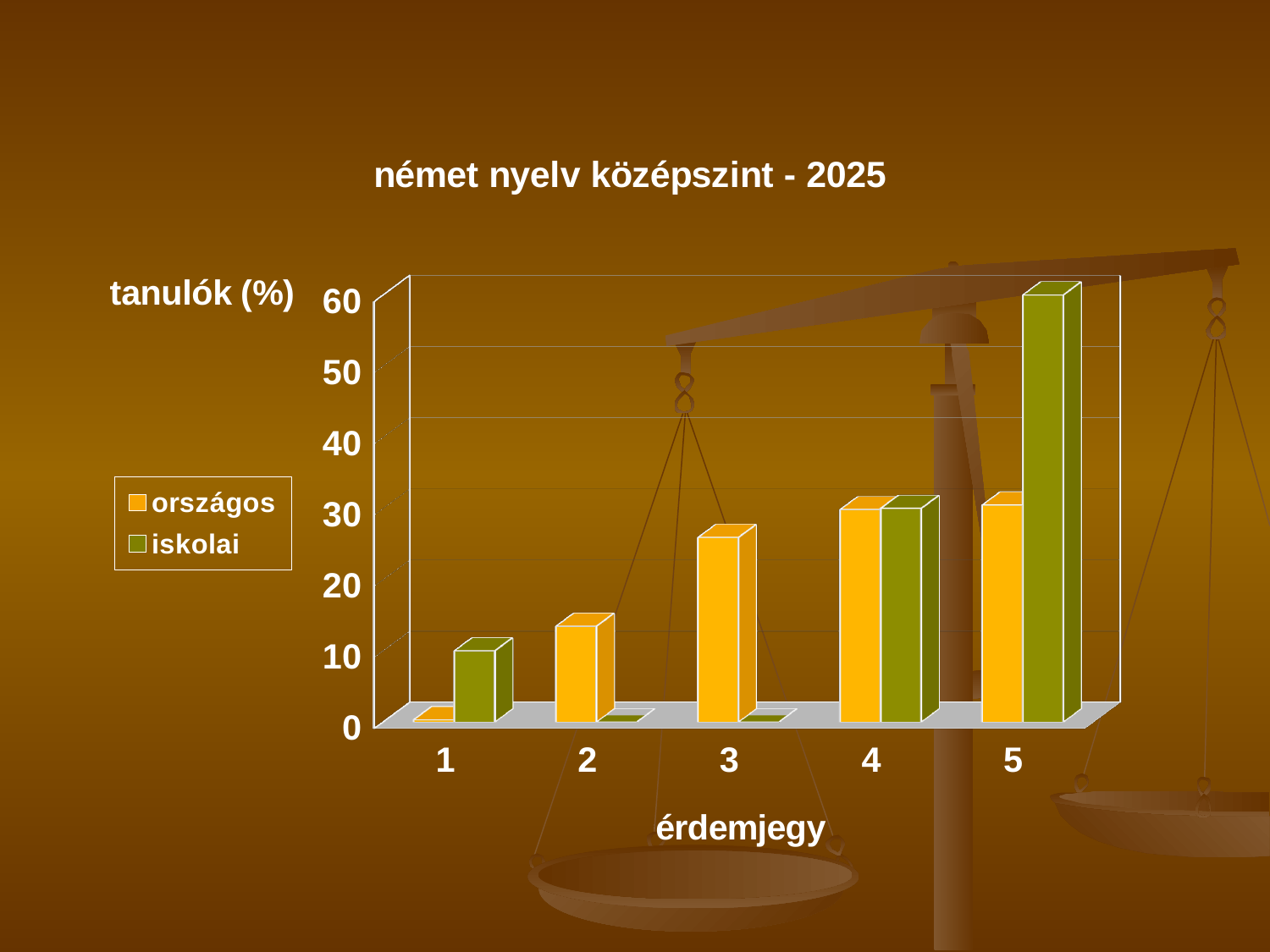
Is the országos value for érdemjegy 3 greater or less than 20? greater What kind of chart is shown on the slide? bar chart Is the iskolai value for érdemjegy 5 greater or less than 50? greater What is the title of the chart? német nyelv középszint - 2025 How many series does the legend list? 2 For érdemjegy 3, which series has the larger value, országos or iskolai? országos Is the országos value for érdemjegy 2 greater or less than 20? less For érdemjegy 5, which series has the larger value, országos or iskolai? iskolai How many érdemjegy categories are shown on the x axis? 5 Which two series are listed in the legend? országos, iskolai For which érdemjegy is the iskolai value highest? 5 For which érdemjegy is the országos value lowest? 1